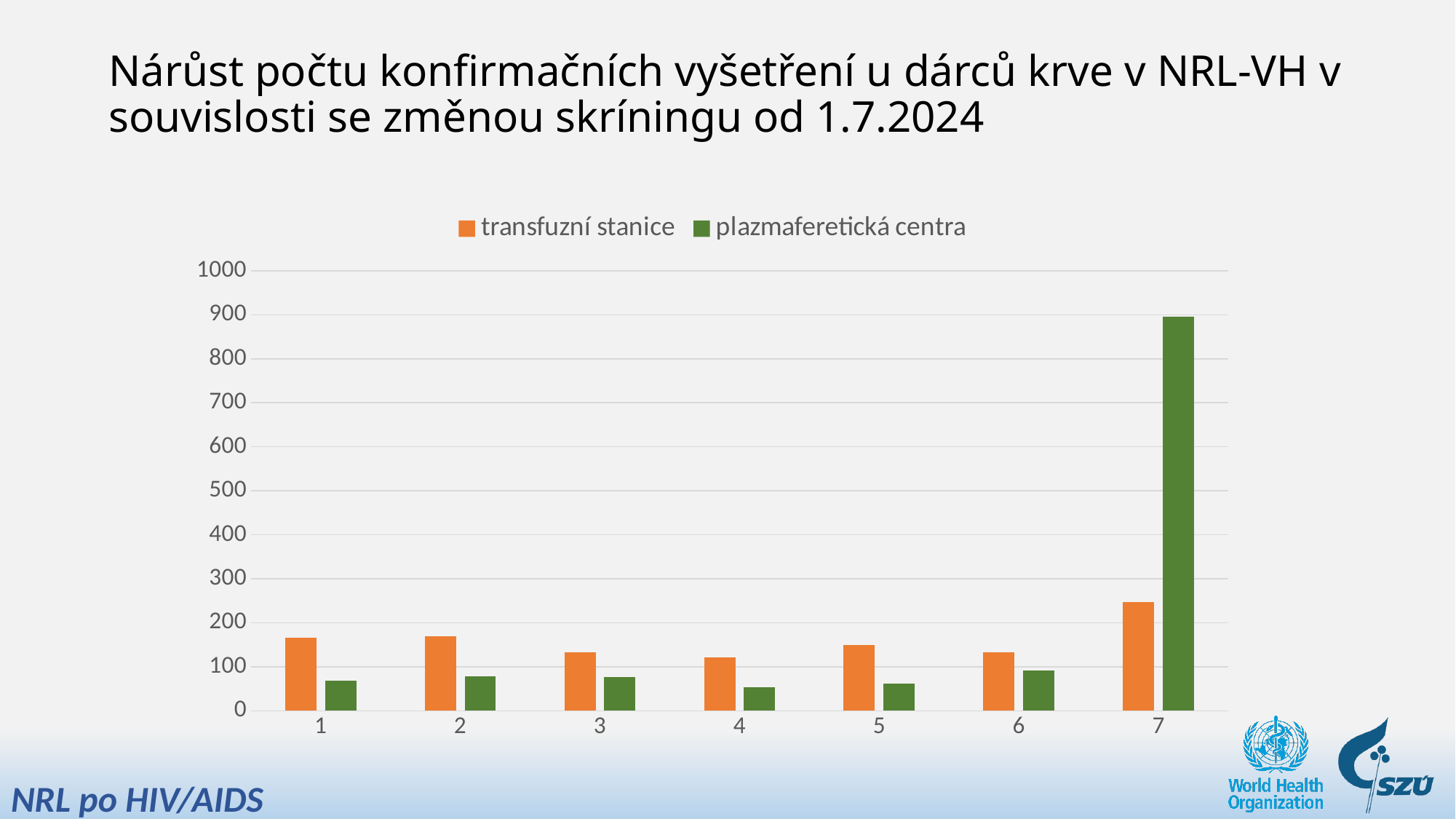
In category 7, which series has the larger value, transfuzní stanice or plazmaferetická centra? plazmaferetická centra How many series does the chart's legend list? 2 How many categories are shown on the x axis of the chart? 7 Which series is shown in green in the chart? plazmaferetická centra Is the value for plazmaferetická centra in category 4 greater or less than 100? less Which colour represents the series transfuzní stanice in the chart? orange Which category has the highest value for transfuzní stanice? 7 Is the value for transfuzní stanice in category 7 greater or less than 200? greater What kind of chart is shown on the slide? bar chart Is the value for plazmaferetická centra in category 7 greater or less than 800? greater Which category has the highest value for plazmaferetická centra? 7 In category 1, which series has the larger value, transfuzní stanice or plazmaferetická centra? transfuzní stanice